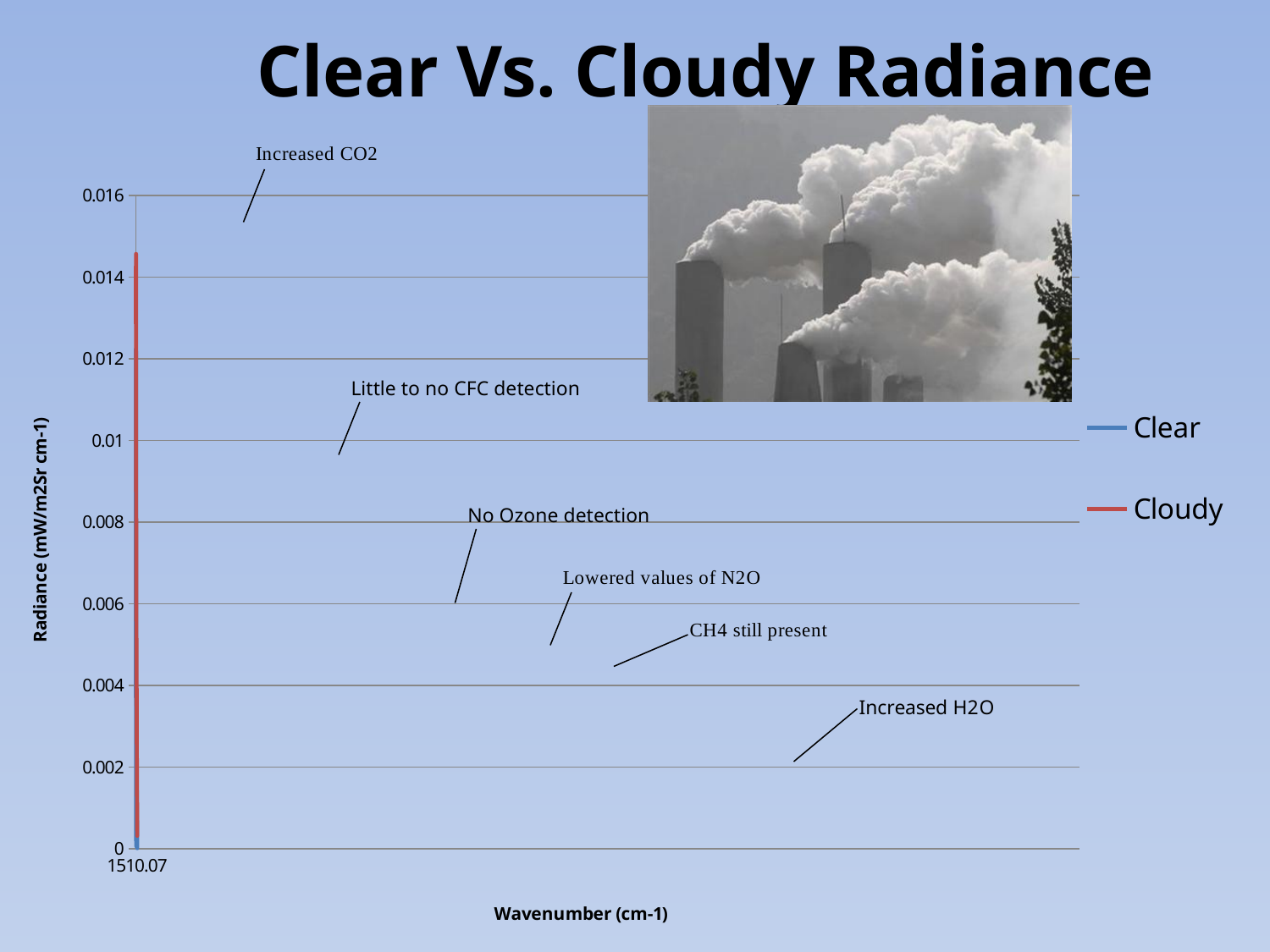
What is the label on the horizontal axis of the chart? Wavenumber (cm-1) What colour is the Cloudy series drawn in? red Is the peak value of the Cloudy series greater or less than 0.012? greater How many series does the chart legend list? 2 What type of chart is shown on the slide? line chart What is the only tick value printed on the horizontal axis? 1510.07 Is the peak value of the Cloudy series greater or less than 0.016? less